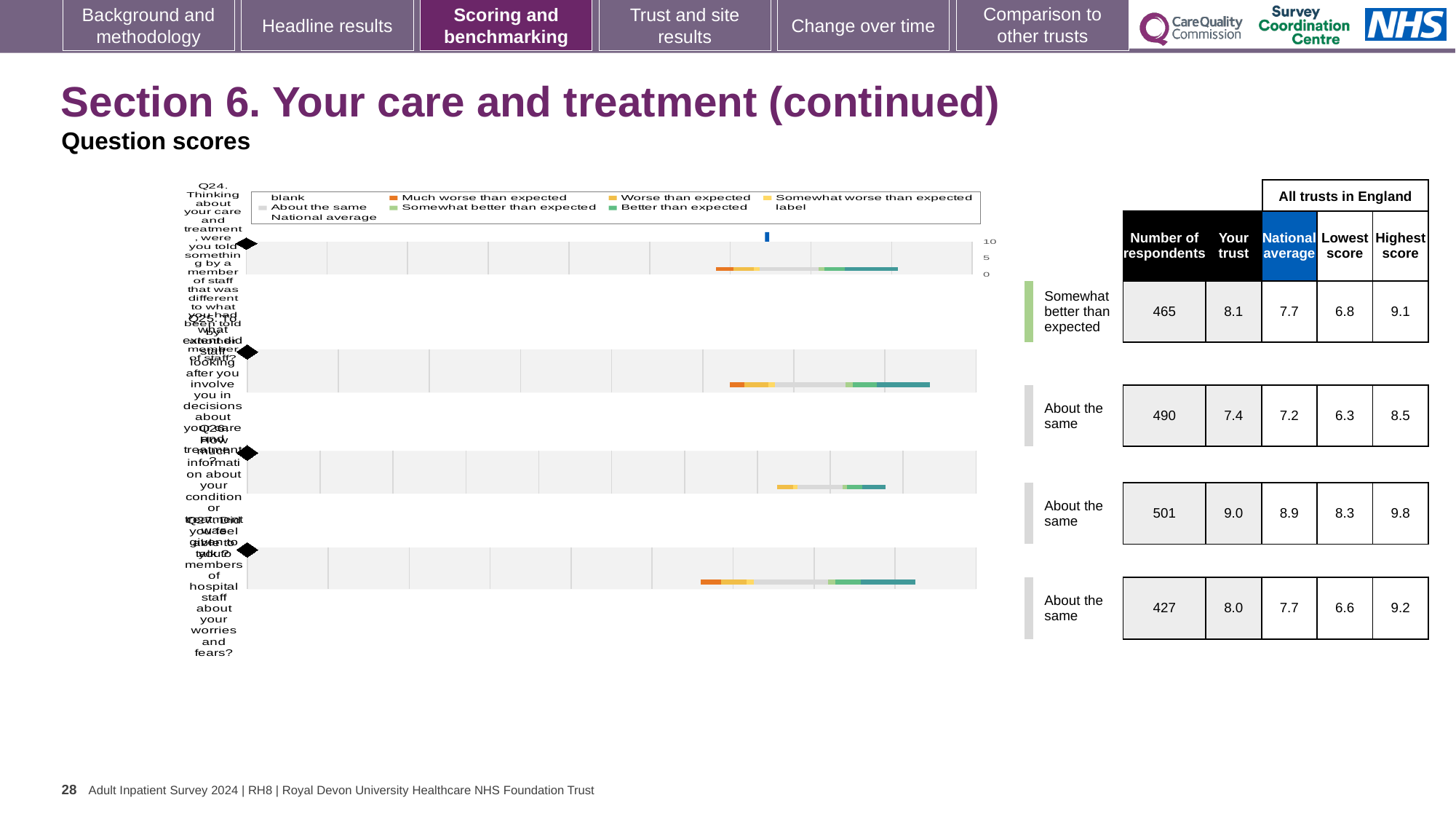
What kind of chart is used to show the question scores on this slide? bar chart In the table beside the charts, what is the 'Your trust' score in the first row (Q24, 'Somewhat better than expected')? 8.1 In the table beside the charts, what is the 'Lowest score' in the third row (Q26)? 8.3 What is the maximum tick value shown on the axis of the first (Q24) chart? 10 In the table beside the charts, for the first row (Q24), which is larger: 'Your trust' or 'National average'? Your trust In the table beside the charts, what is the difference between 'Your trust' and 'National average' in the first row (Q24)? 0.4 In the table beside the charts, what is the number of respondents in the second row (Q25)? 490 How many separate question charts (Q24 to Q27) are shown on the slide? 4 In the table beside the charts, what is the 'Highest score' in the fourth row (Q27)? 9.2 In the table beside the charts, which row has the highest 'Your trust' score? the third row (Q26), 9.0 In the chart legend, what colour represents 'Better than expected'? green In the chart legend, what colour represents 'Much worse than expected'? orange